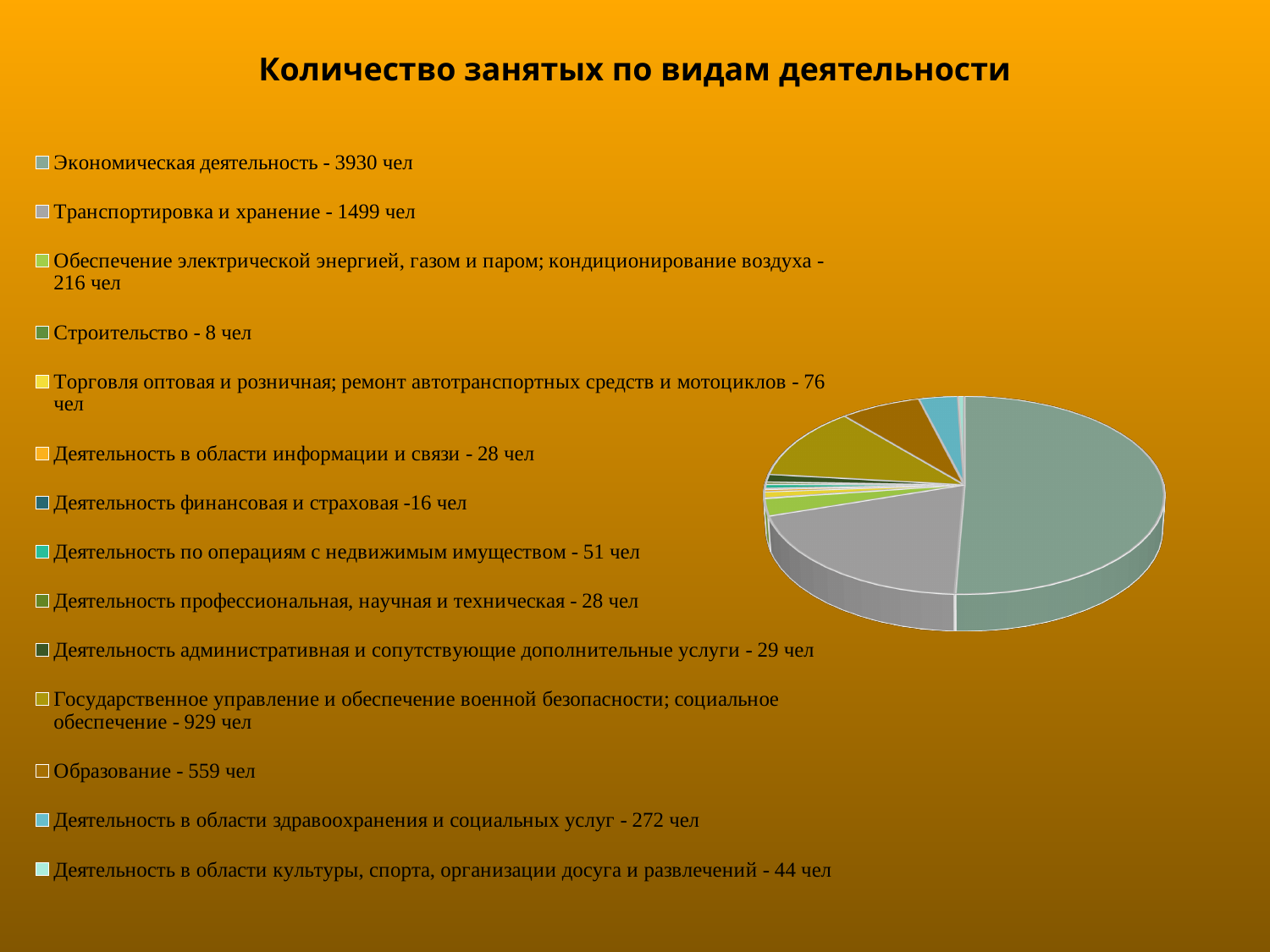
What kind of chart is shown on the slide? pie chart How many categories does the pie chart have? 14 What is the value for Государственное управление и обеспечение военной безопасности; социальное обеспечение? 929 чел What is the difference between Государственное управление и обеспечение военной безопасности; социальное обеспечение and Образование? 370 чел How many people are employed in Экономическая деятельность? 3930 чел What is the title of the chart? Количество занятых по видам деятельности What is the value for Транспортировка и хранение? 1499 чел Which category has the largest number of employed people? Экономическая деятельность What is the value for Образование? 559 чел Which category has the smallest number of employed people? Строительство What is the difference between Экономическая деятельность and Транспортировка и хранение? 2431 чел Which is larger: Образование or Деятельность в области здравоохранения и социальных услуг? Образование